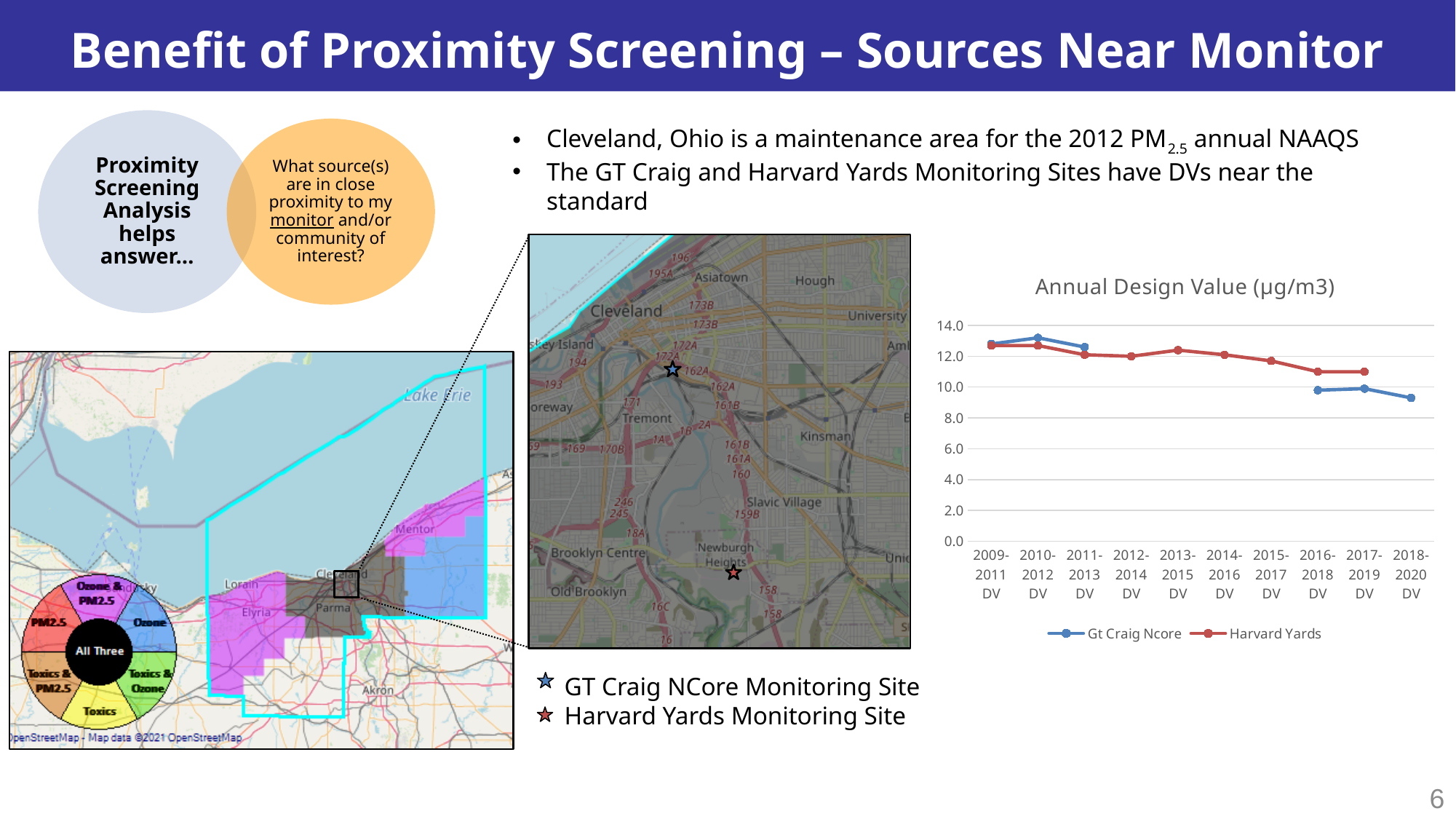
In the Annual Design Value chart, is the Gt Craig Ncore value for 2018-2020 DV greater or less than 10.0? less In the Annual Design Value chart, is the Harvard Yards value for 2016-2018 DV greater or less than 10.0? greater In the Annual Design Value chart, which series has the higher value for 2017-2019 DV? Harvard Yards What is the title of the line chart on the slide? Annual Design Value (µg/m3) In the Annual Design Value chart, for which period is the Gt Craig Ncore value lowest? 2018-2020 DV How many design-value periods are shown on the x axis of the Annual Design Value chart? 10 In the Annual Design Value chart, is the Gt Craig Ncore value for 2010-2012 DV greater or less than 12.0? greater How many series does the legend of the Annual Design Value chart list? 2 What kind of chart is the Annual Design Value chart? line chart In the Annual Design Value chart, do the values for Harvard Yards generally rise or fall from 2009-2011 DV to 2017-2019 DV? fall In the Annual Design Value chart, which series has the higher value for 2010-2012 DV? Gt Craig Ncore In the Annual Design Value chart, which series is drawn in red? Harvard Yards